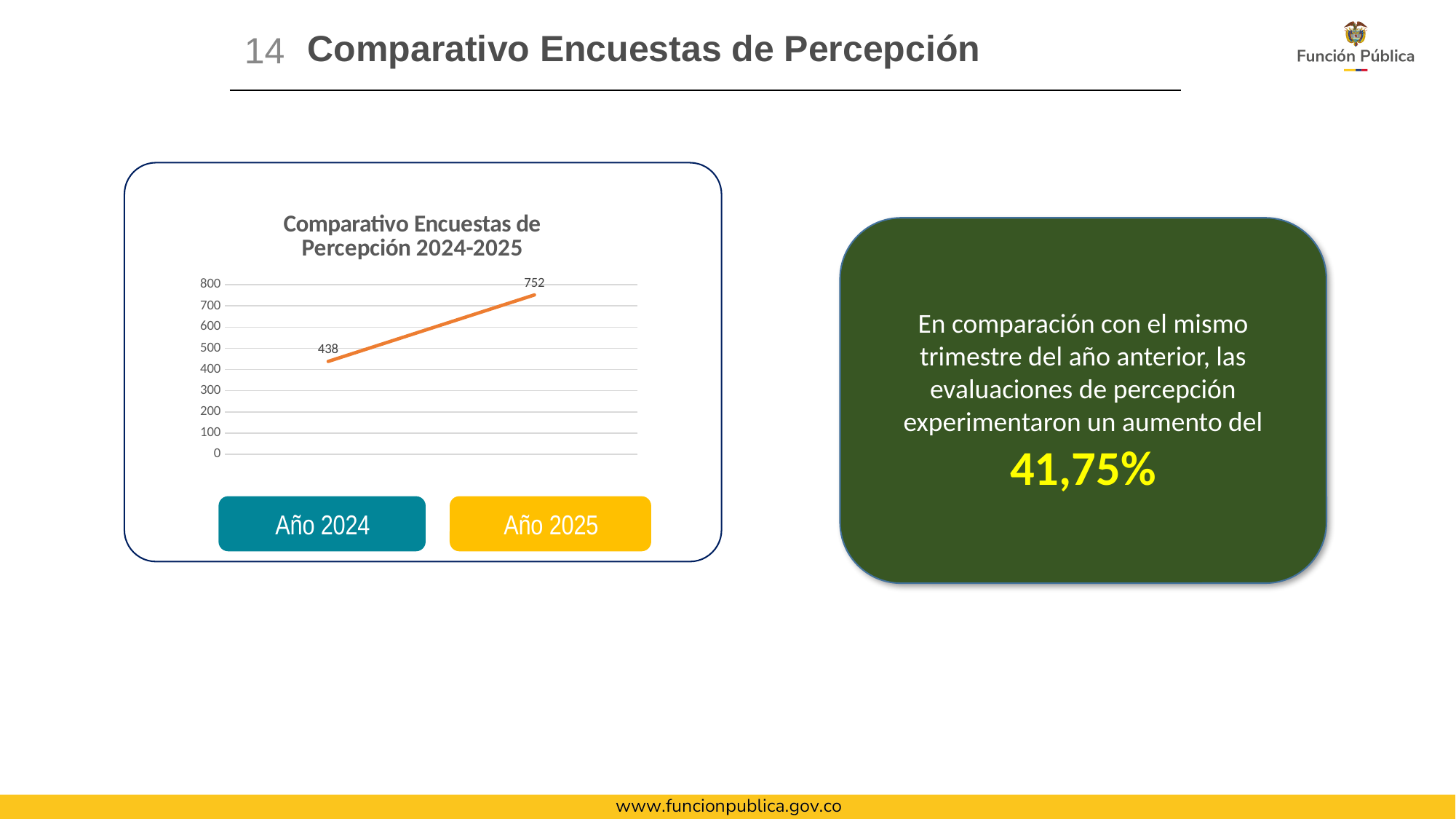
Is the value for Año 2025 greater or less than 700? greater What kind of chart is shown? line chart Is the value for Año 2024 greater or less than 500? less What is the difference between the values for Año 2025 and Año 2024? 314 Do the values rise or fall from Año 2024 to Año 2025? rise Is the value for Año 2024 larger or smaller than the value for Año 2025? smaller What is the value for Año 2024? 438 What is the title of the chart? Comparativo Encuestas de Percepción 2024-2025 How many data points are plotted on the chart? 2 Which year has the lower value? Año 2024 Which year has the higher value? Año 2025 What is the value for Año 2025? 752